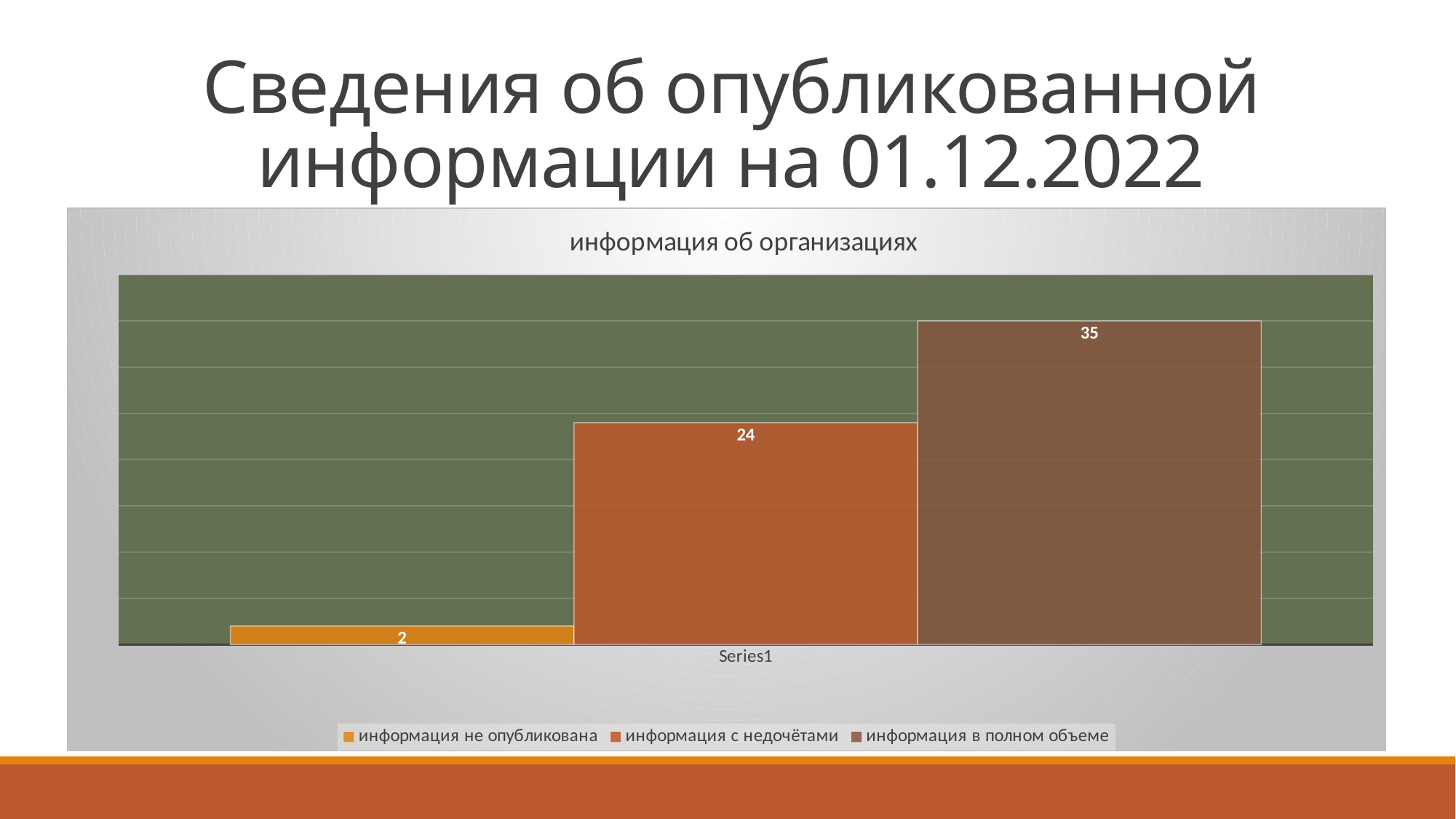
What is the value for 'информация с недочётами'? 24 What kind of chart is shown? bar chart Which series has the highest value? информация в полном объеме Which is larger: 'информация с недочётами' or 'информация не опубликована'? информация с недочётами What is the label on the x axis under the bars? Series1 What is the value for 'информация не опубликована'? 2 What is the title of the chart? информация об организациях What is the difference between 'информация с недочётами' and 'информация не опубликована'? 22 How many series does the legend list? 3 What is the value for 'информация в полном объеме'? 35 Which series has the lowest value? информация не опубликована What is the difference between 'информация в полном объеме' and 'информация с недочётами'? 11